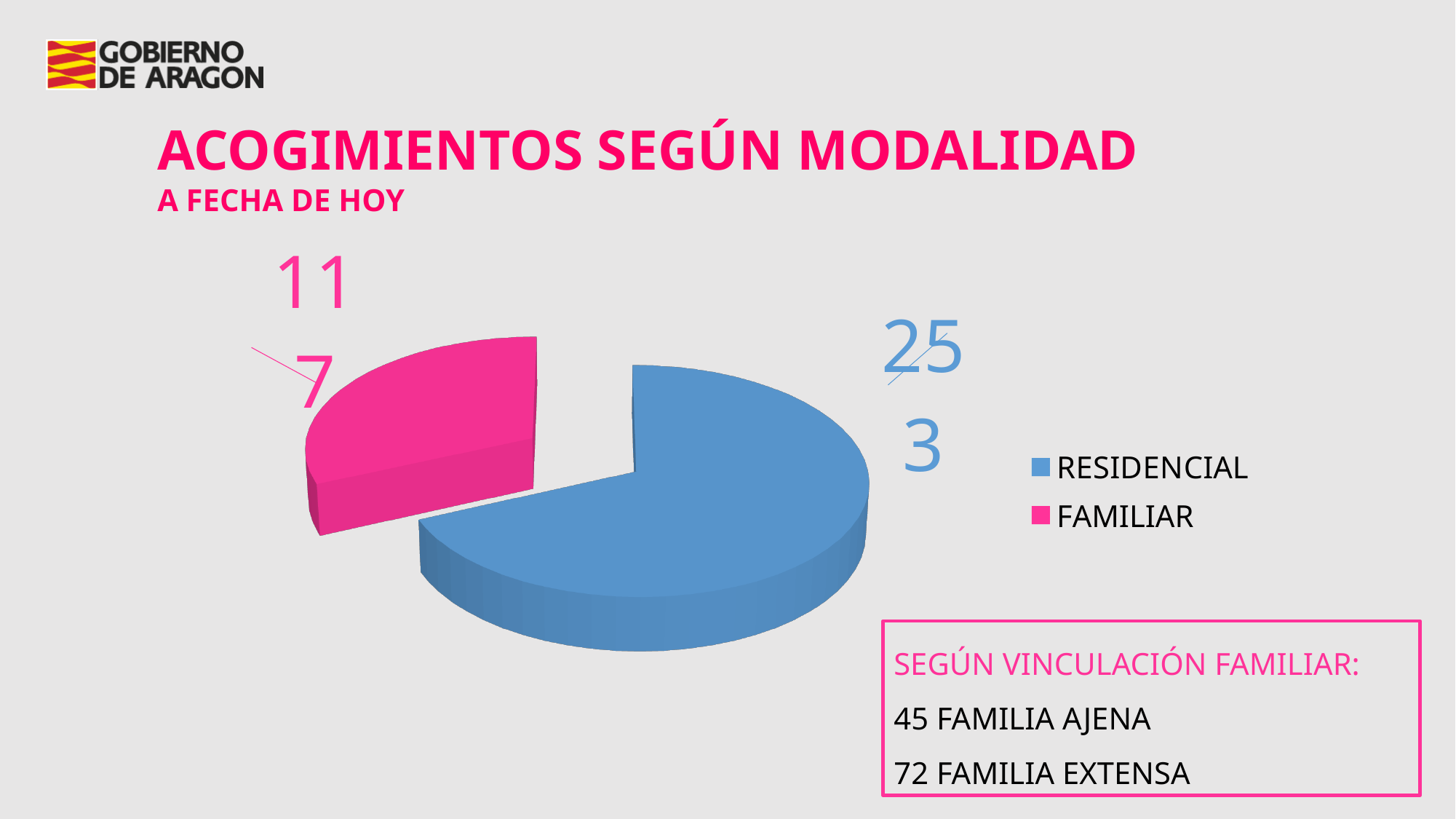
What kind of chart is shown on the slide? pie chart What is the value shown for FAMILIAR? 117 Which category has the largest slice of the pie? RESIDENCIAL What is the title of the chart on the slide? ACOGIMIENTOS SEGÚN MODALIDAD What is the total of the two slices in the pie chart? 370 How many entries does the legend list? 2 What is the difference between the RESIDENCIAL and FAMILIAR values? 136 What colour is the FAMILIAR slice? pink Which is larger, RESIDENCIAL or FAMILIAR? RESIDENCIAL Which category has the smallest slice of the pie? FAMILIAR How many slices does the pie chart have? 2 What is the value shown for RESIDENCIAL? 253